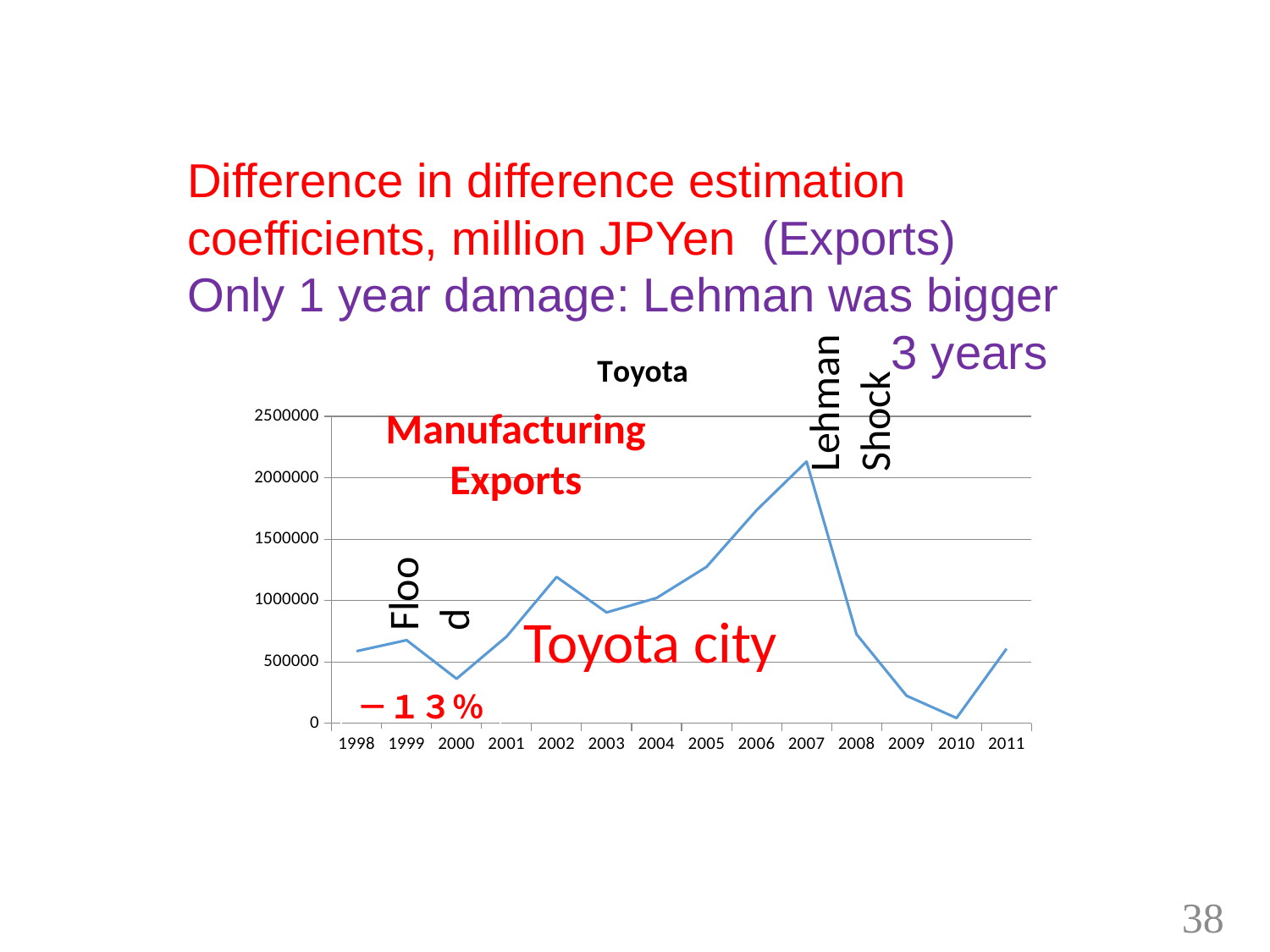
Which year has the larger value, 2002 or 2003? 2002 Which year has the larger value, 2007 or 2008? 2007 Is the value for 2009 greater or less than 500000? less How many years are plotted along the x axis of the chart? 14 What is the title of the chart? Toyota Is the value for 2000 greater or less than 500000? less What kind of chart is shown on the slide? line chart Is the value for 2006 greater or less than 1500000? greater Which year has the lowest value in the chart? 2010 Which year has the highest value in the chart? 2007 Do the values rise or fall from 2007 to 2010? fall